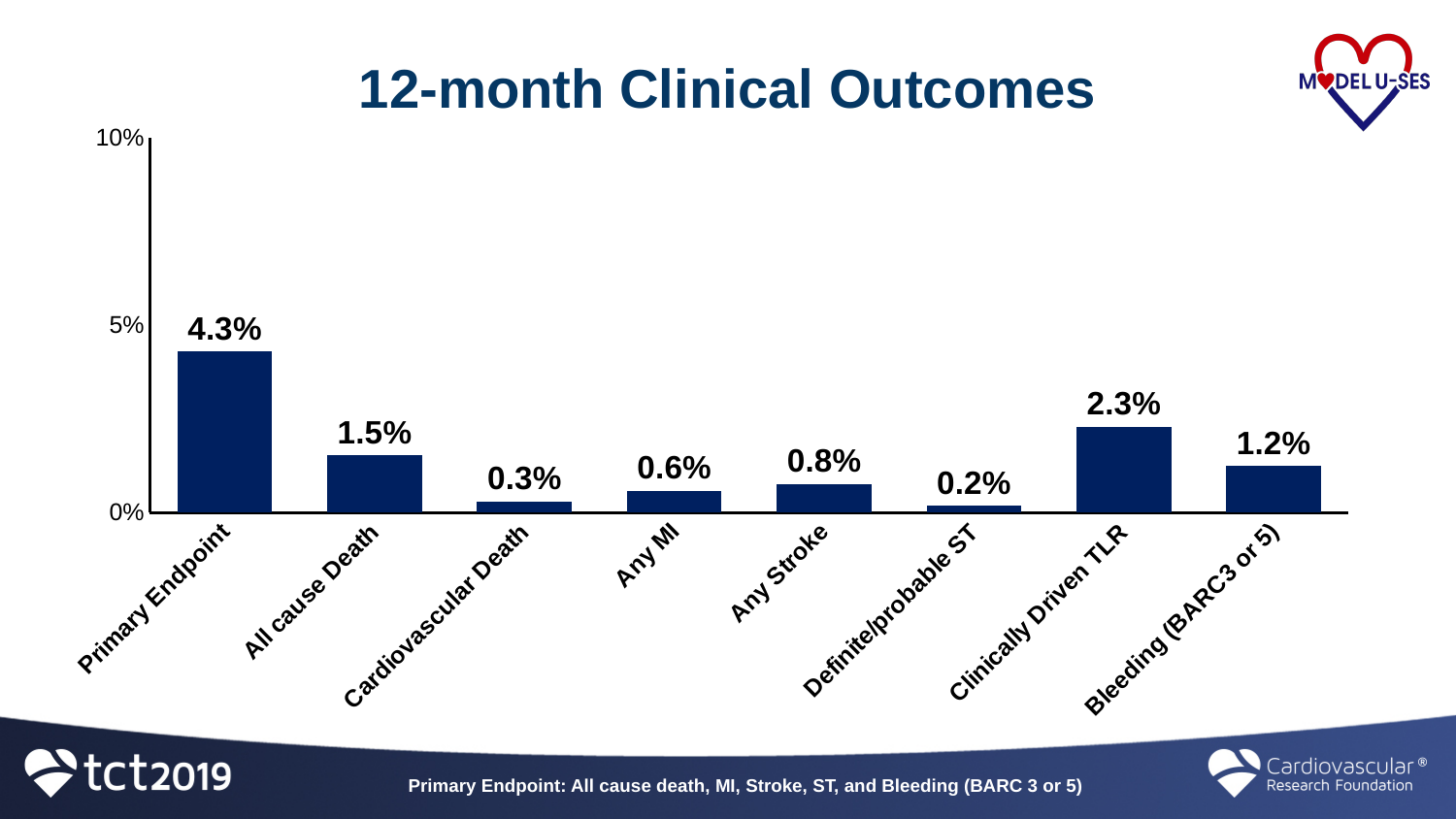
What is the value for Definite/probable ST? 0.2% What is the value for Any Stroke? 0.8% How many categories are shown on the x axis? 8 What is the difference between the values for Clinically Driven TLR and Bleeding (BARC3 or 5)? 1.1% What is the value for Primary Endpoint? 4.3% Is the value for Primary Endpoint greater or less than 5%? less What is the difference between the values for Primary Endpoint and All cause Death? 2.8% Which category has the lowest value? Definite/probable ST Which is larger, the value for Any MI or the value for Cardiovascular Death? Any MI Which category has the highest value? Primary Endpoint What is the value for Clinically Driven TLR? 2.3% What kind of chart is shown on the slide? bar chart